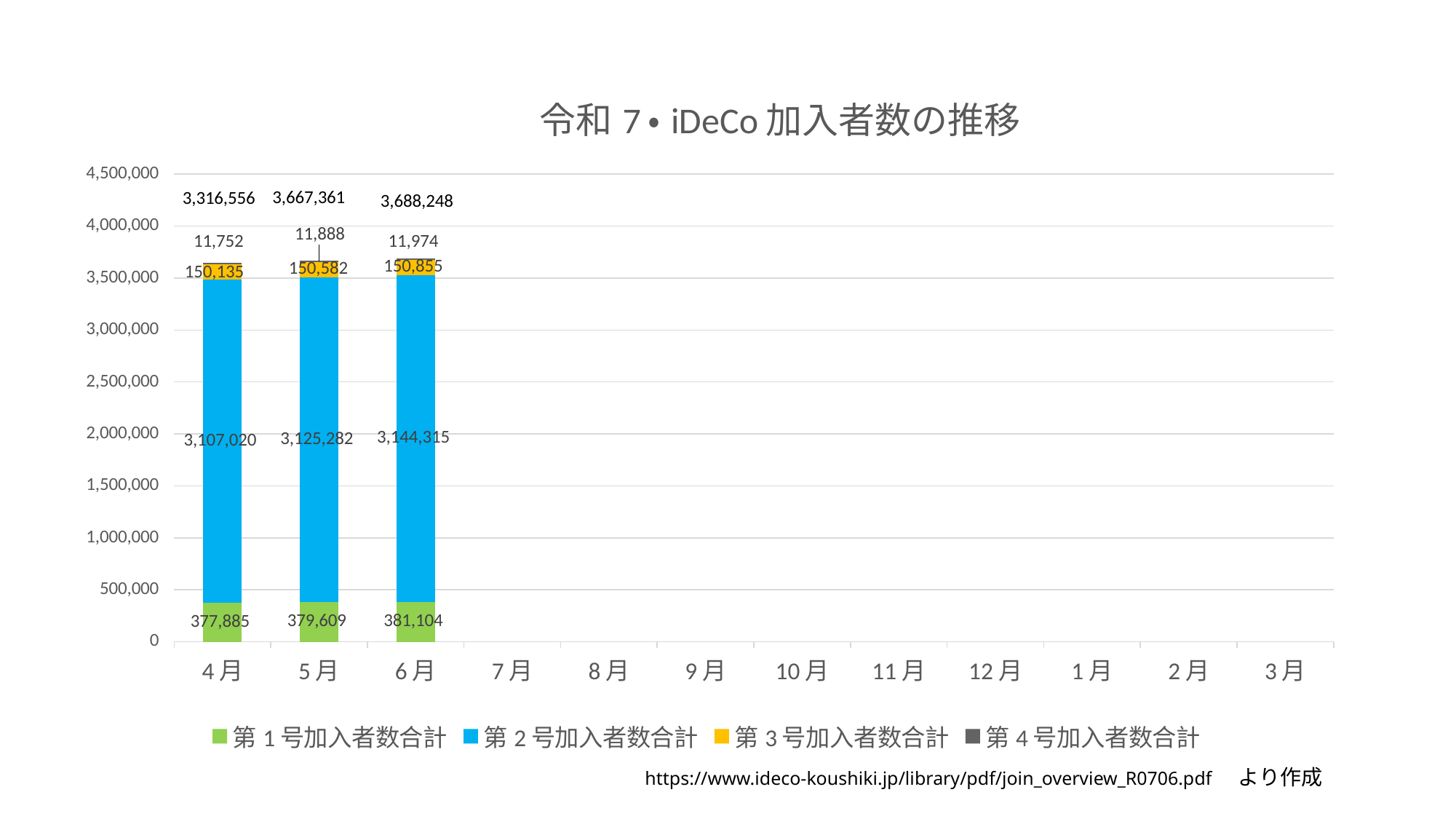
What is the value of 第2号加入者数合計 for 5月? 3,125,282 What kind of chart is shown on the slide? bar chart What is the difference between the 第2号加入者数合計 values for 6月 and 4月? 37,295 How many series does the legend list? 4 Which is larger, the 第1号加入者数合計 value for 4月 or for 6月? 6月 What is the value of 第3号加入者数合計 for 4月? 150,135 What is the value of 第4号加入者数合計 for 5月? 11,888 What is the title of the chart? 令和7・iDeCo加入者数の推移 What is the value of 第1号加入者数合計 for 6月? 381,104 What is the total of the stacked bar for 6月? 3,688,248 How many months on the x axis have bars plotted? 3 Does the 第2号加入者数合計 value rise or fall from 4月 to 6月? rise